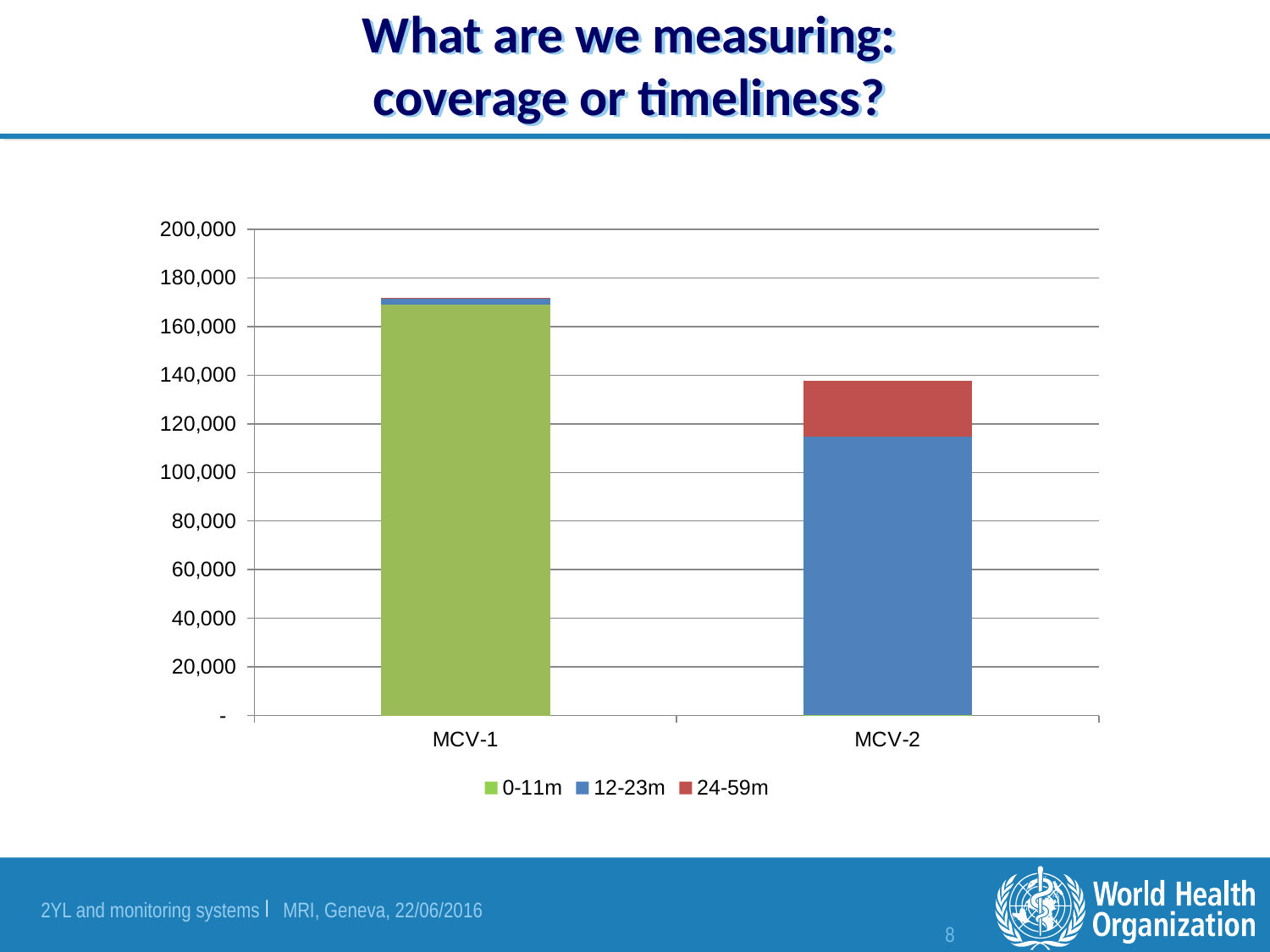
What kind of chart is shown on the slide? Stacked bar chart Which category has the taller stacked bar, MCV-1 or MCV-2? MCV-1 Is the total value for MCV-2 greater or less than 120,000? greater Is the total value for MCV-1 greater or less than 160,000? greater Is the total value for MCV-2 greater or less than 160,000? less How many series does the chart's legend list? 3 What colour represents the 24-59m series in the chart? Red Which category has the lowest total bar height? MCV-2 Which series makes up almost all of the MCV-1 bar? 0-11m Which category has the highest total bar height? MCV-1 How many categories are shown on the x axis of the chart? 2